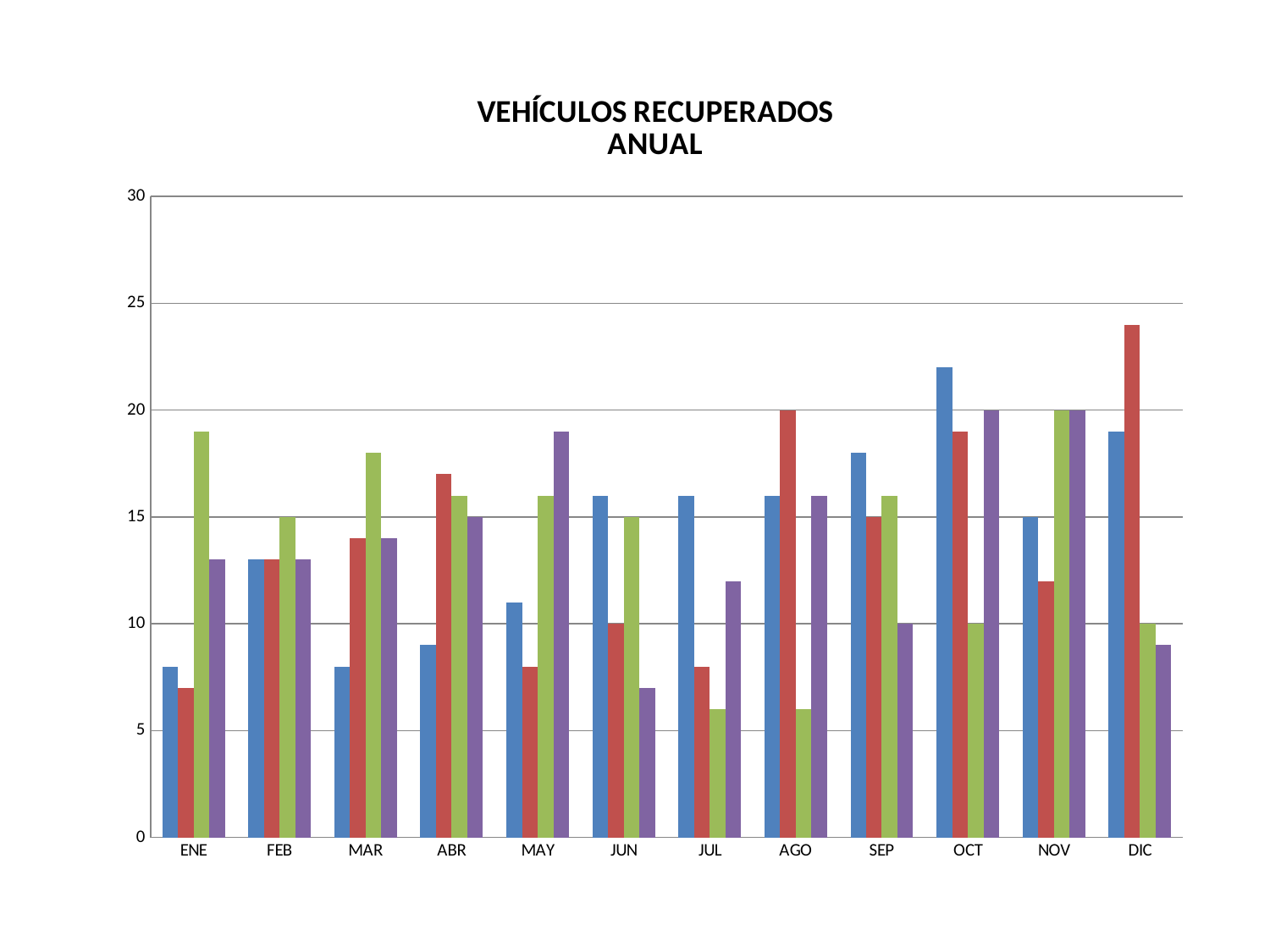
In which month is the blue bar the highest? OCT What is the value of the purple bar for OCT? 20 How many bars are plotted for each month? 4 Is the value of the red bar for DIC greater or less than 20? greater What kind of chart is shown on the slide? bar chart How many months (categories) are shown on the x axis? 12 Is the value of the green bar for JUL greater or less than 10? less In which month is the red bar the highest? DIC What is the title of the chart? VEHÍCULOS RECUPERADOS ANUAL What is the value of the red bar for AGO? 20 Is the value of the blue bar for OCT greater or less than 20? greater